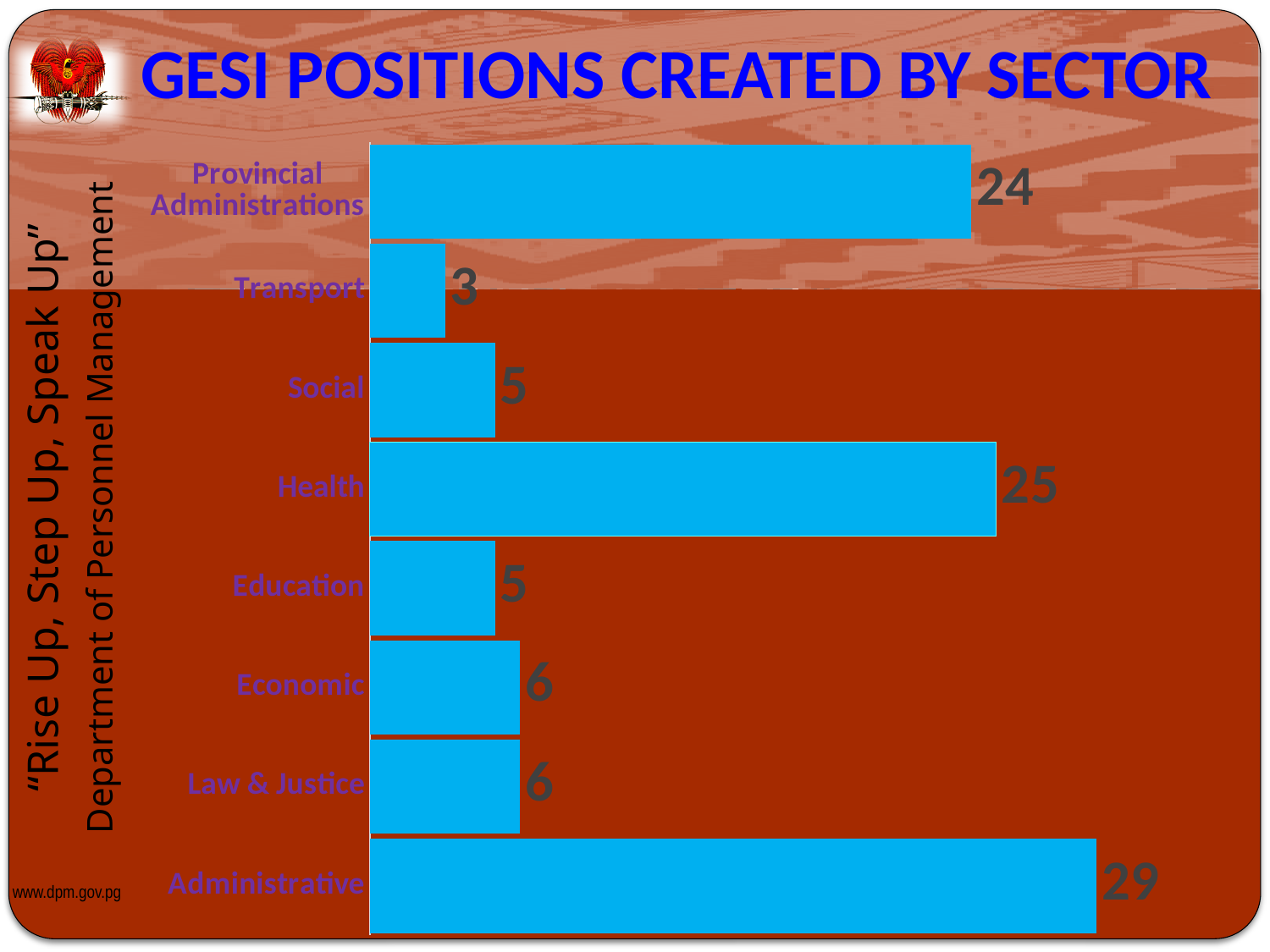
What is the value for Administrative? 29 What is the difference between the values for Administrative and Health? 4 What is the value for Health? 25 What is the title of the chart? GESI POSITIONS CREATED BY SECTOR Which sector has the lowest number of GESI positions created? Transport Which is larger, the value for Economic or the value for Social? Economic What is the difference between the values for Provincial Administrations and Transport? 21 Which sector has the highest number of GESI positions created? Administrative What kind of chart is shown on the slide? Bar chart What is the value for Provincial Administrations? 24 What is the value for Transport? 3 How many sectors are shown in the chart? 8